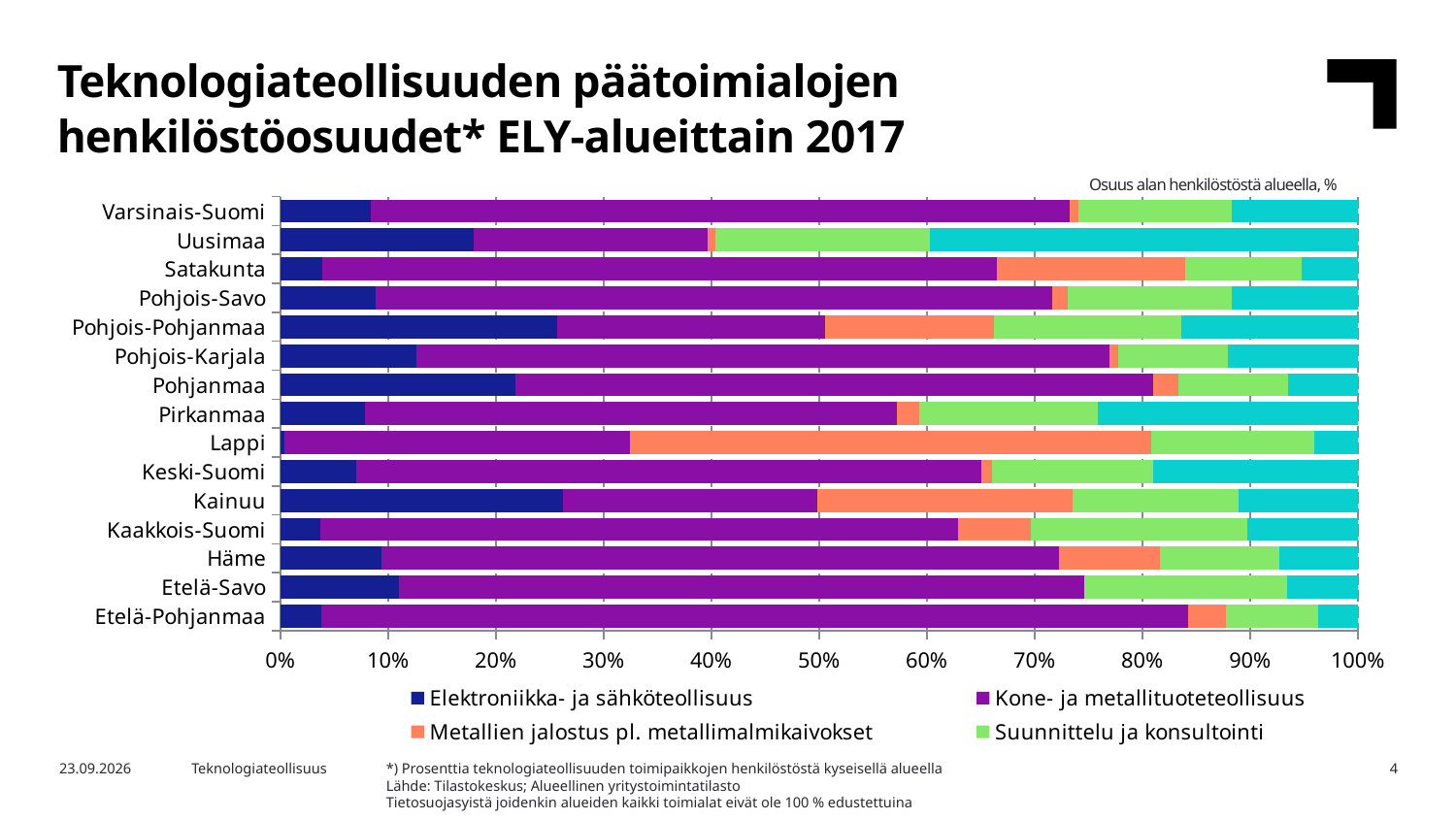
Which region has the largest share for Metallien jalostus pl. metallimalmikaivokset? Lappi Is the Kone- ja metallituoteteollisuus share for Etelä-Pohjanmaa greater or less than 70%? greater Which region has a larger Elektroniikka- ja sähköteollisuus share, Pohjanmaa or Häme? Pohjanmaa How many series does the chart legend list? 4 Is the Metallien jalostus pl. metallimalmikaivokset share for Lappi greater or less than 40%? greater What is the maximum value shown on the horizontal axis of the chart? 100% How many ELY regions are listed on the vertical axis of the chart? 15 Is the Elektroniikka- ja sähköteollisuus share for Kainuu greater or less than 20%? greater What kind of chart is shown on the slide? Stacked bar chart What is the title of the chart on the slide? Teknologiateollisuuden päätoimialojen henkilöstöosuudet* ELY-alueittain 2017 Which region has a larger Metallien jalostus pl. metallimalmikaivokset share, Lappi or Satakunta? Lappi